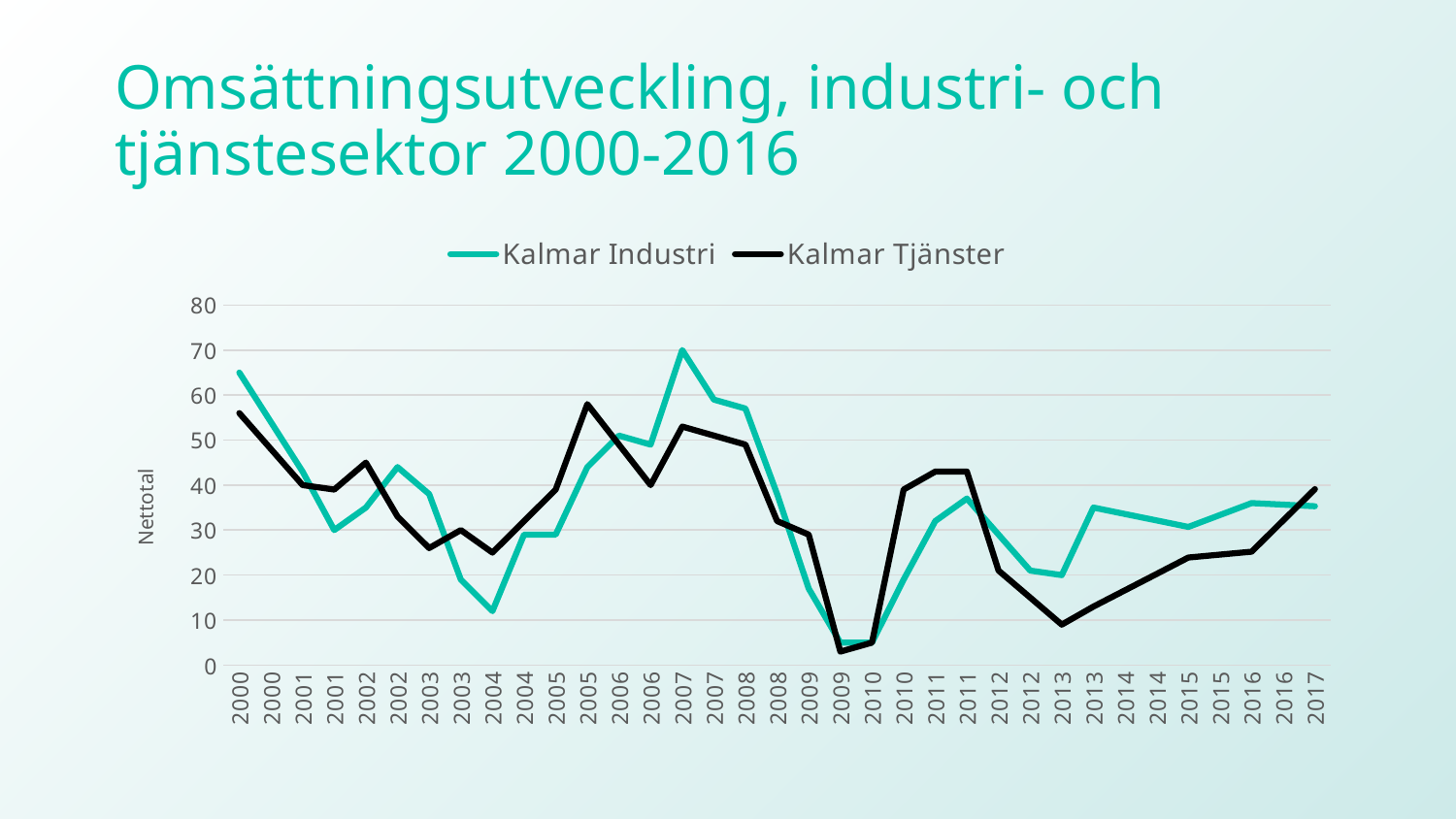
What is the label on the vertical axis? Nettotal Is the value for Kalmar Industri at the first 2004 point greater or less than 20? less Does the Kalmar Industri line rise or fall from 2000 to 2004? Fall In which year does the Kalmar Industri line reach its highest value? 2007 Is the value for Kalmar Industri at the first 2000 point greater or less than 60? greater Is the value for Kalmar Tjänster at the second 2009 point greater or less than 10? less What are the two series named in the legend? Kalmar Industri and Kalmar Tjänster At the first 2007 point, which series has the higher value, Kalmar Industri or Kalmar Tjänster? Kalmar Industri At the first 2004 point, which series has the higher value, Kalmar Industri or Kalmar Tjänster? Kalmar Tjänster How many series does the legend list? 2 What kind of chart is shown on the slide? Line chart